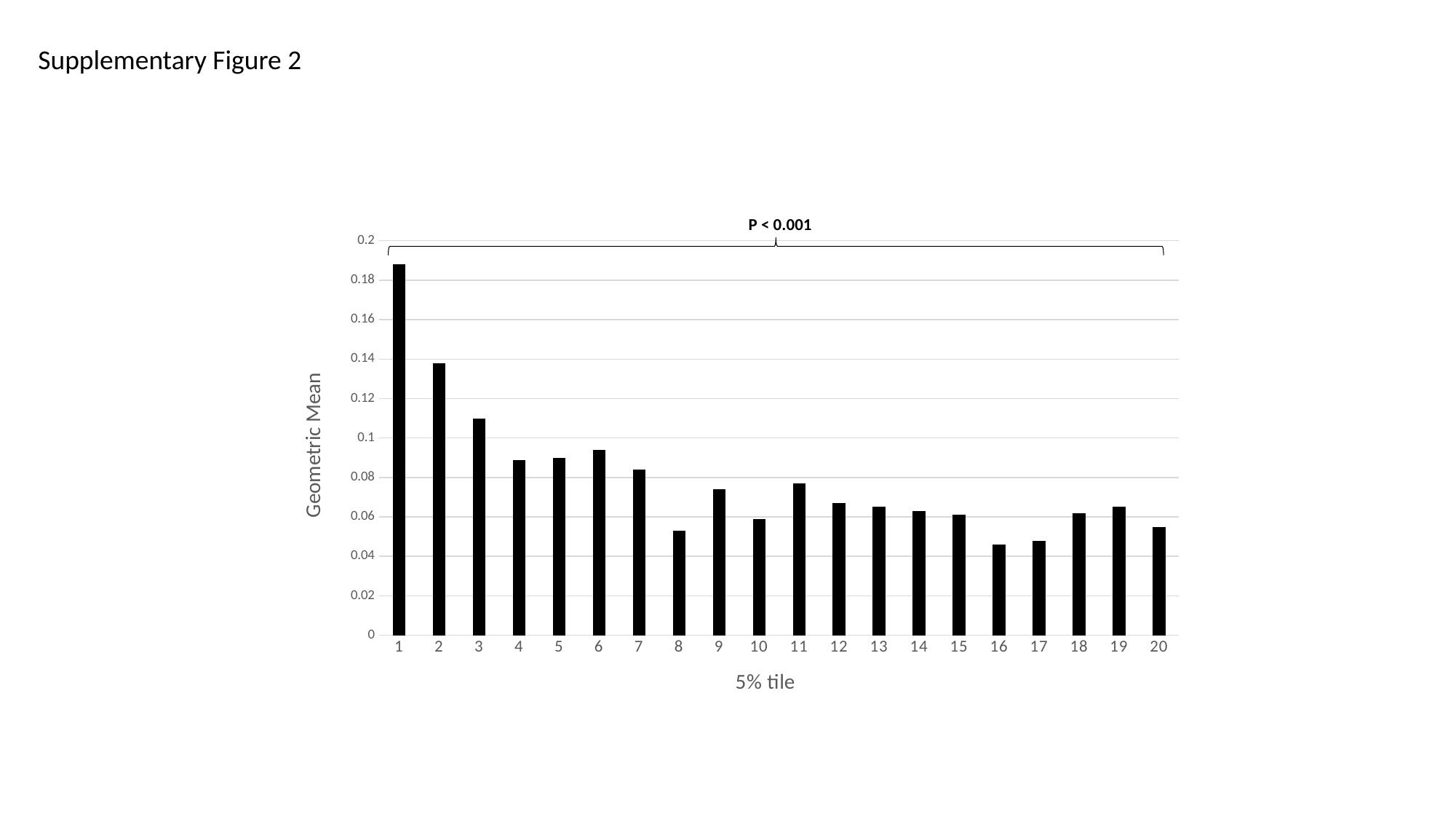
Is the geometric mean for 5% tile 1 greater or less than 0.18? greater What kind of chart is shown on the slide? bar chart Is the geometric mean for 5% tile 3 greater or less than 0.1? greater How many categories (5% tiles) are plotted on the x axis? 20 Which 5% tile has the highest geometric mean? 1 Which has a larger geometric mean, 5% tile 2 or 5% tile 3? 2 Is the geometric mean for 5% tile 8 greater or less than 0.06? less Do the geometric mean values generally rise or fall from 5% tile 1 to 5% tile 20? fall Which has a larger geometric mean, 5% tile 16 or 5% tile 18? 18 Which has a larger geometric mean, 5% tile 8 or 5% tile 9? 9 What is the title of the y axis? Geometric Mean